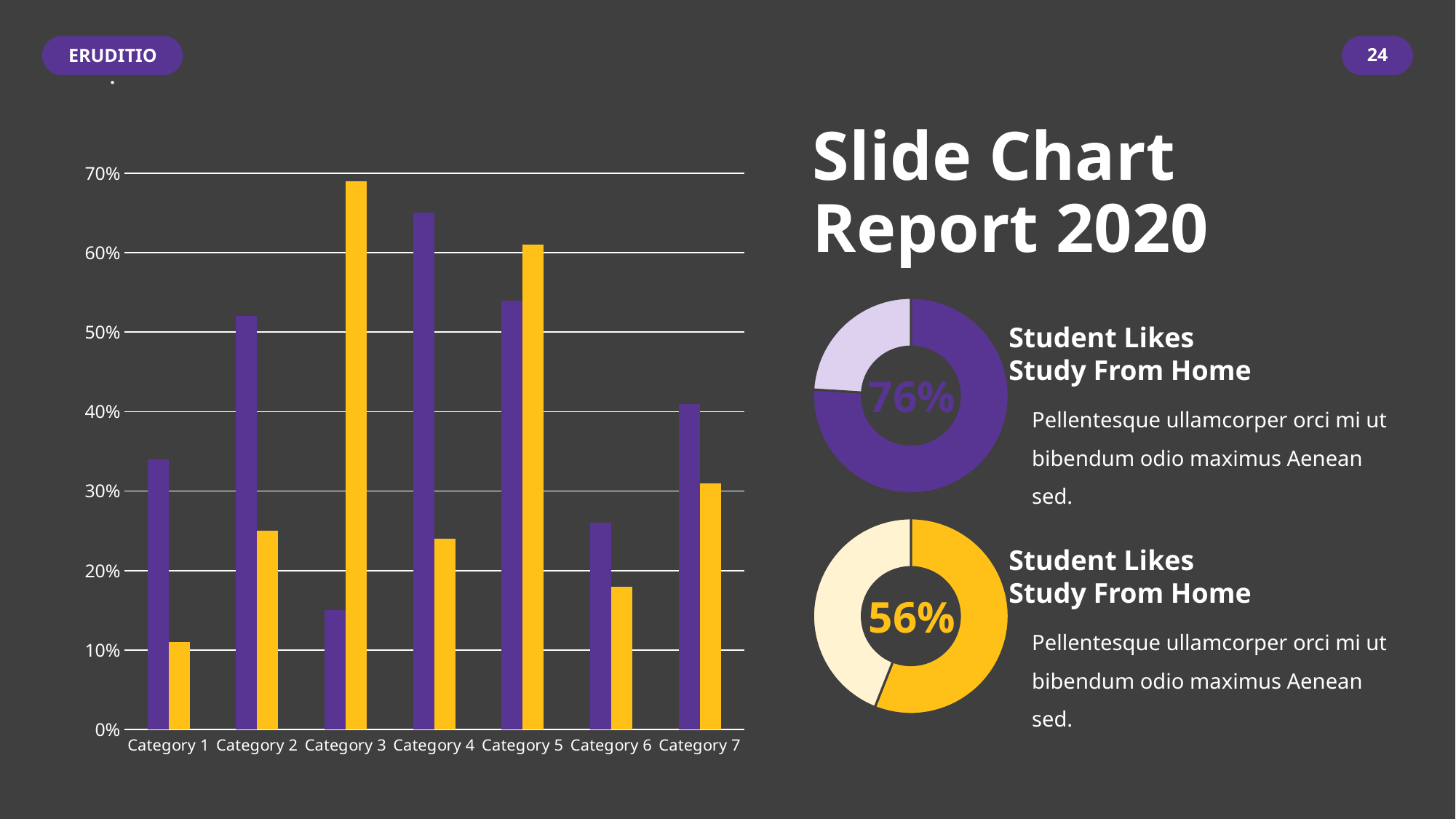
What kind of chart is the chart on the left side of the slide? bar chart In the bar chart, which is taller for Category 7, the purple bar or the yellow bar? the purple bar In the bar chart, which is taller for Category 5, the purple bar or the yellow bar? the yellow bar How many categories are shown on the x axis of the bar chart? 7 In the bar chart, is the purple bar for Category 2 greater or less than 50%? greater What percentage is shown in the centre of the purple donut chart? 76% In the bar chart, which category has the tallest yellow bar? Category 3 In the bar chart, which category has the shortest purple bar? Category 3 In the bar chart, which category has the shortest yellow bar? Category 1 In the bar chart, which category has the tallest purple bar? Category 4 What percentage is shown in the centre of the yellow donut chart? 56% In the bar chart, is the yellow bar for Category 6 greater or less than 20%? less